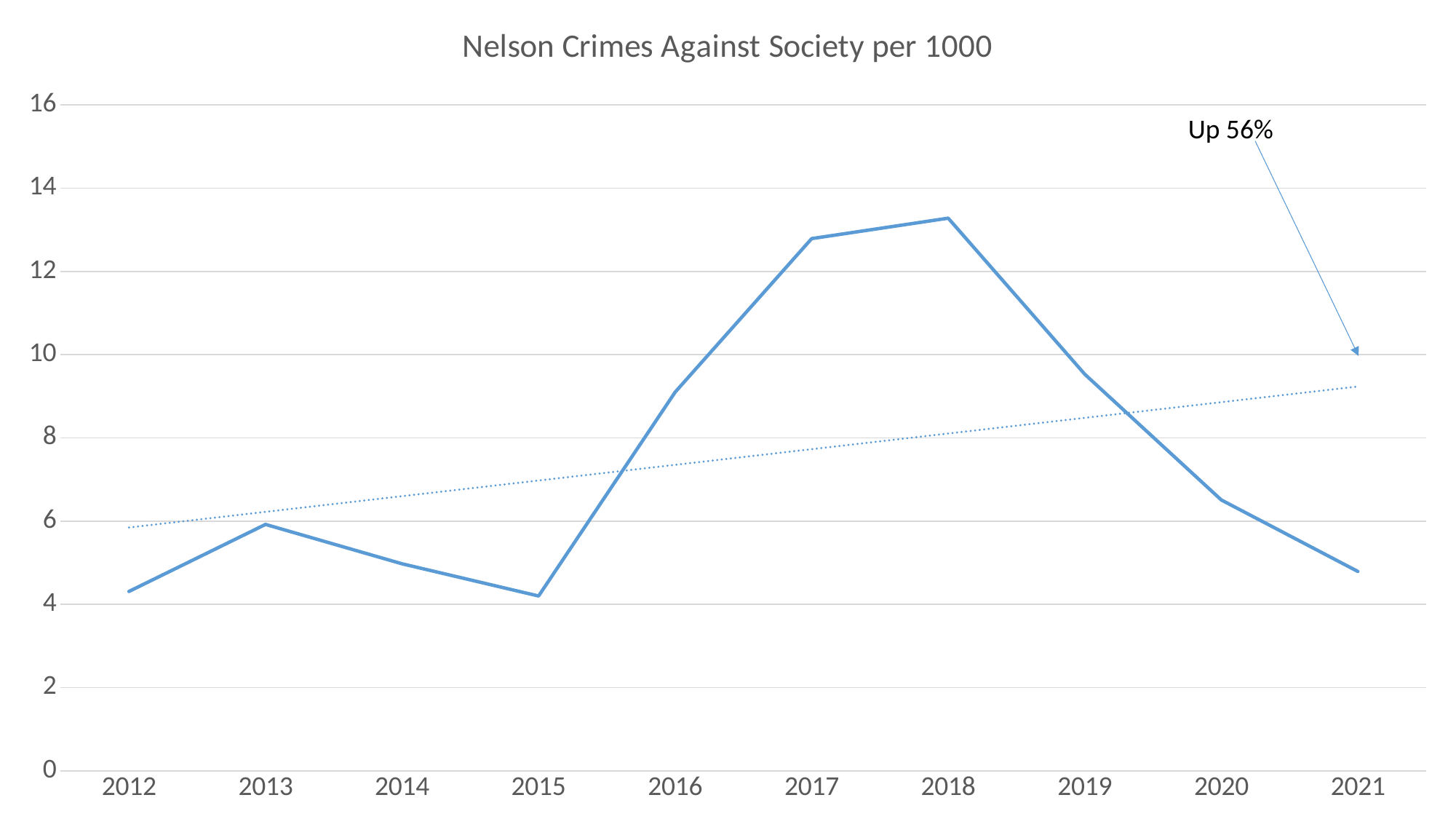
What is the title of the chart? Nelson Crimes Against Society per 1000 Which year has the larger value, 2016 or 2020? 2016 Is the value for 2016 greater or less than 8? greater What kind of chart is shown on the slide? line chart Is the value for 2017 greater or less than 12? greater Do the values rise or fall from 2018 to 2021? fall What does the text annotation with the arrow pointing to the dotted trend line say? Up 56% Is the value for 2021 greater or less than 6? less How many years are plotted along the x axis? 10 Which year has the highest value? 2018 Which year has the larger value, 2017 or 2019? 2017